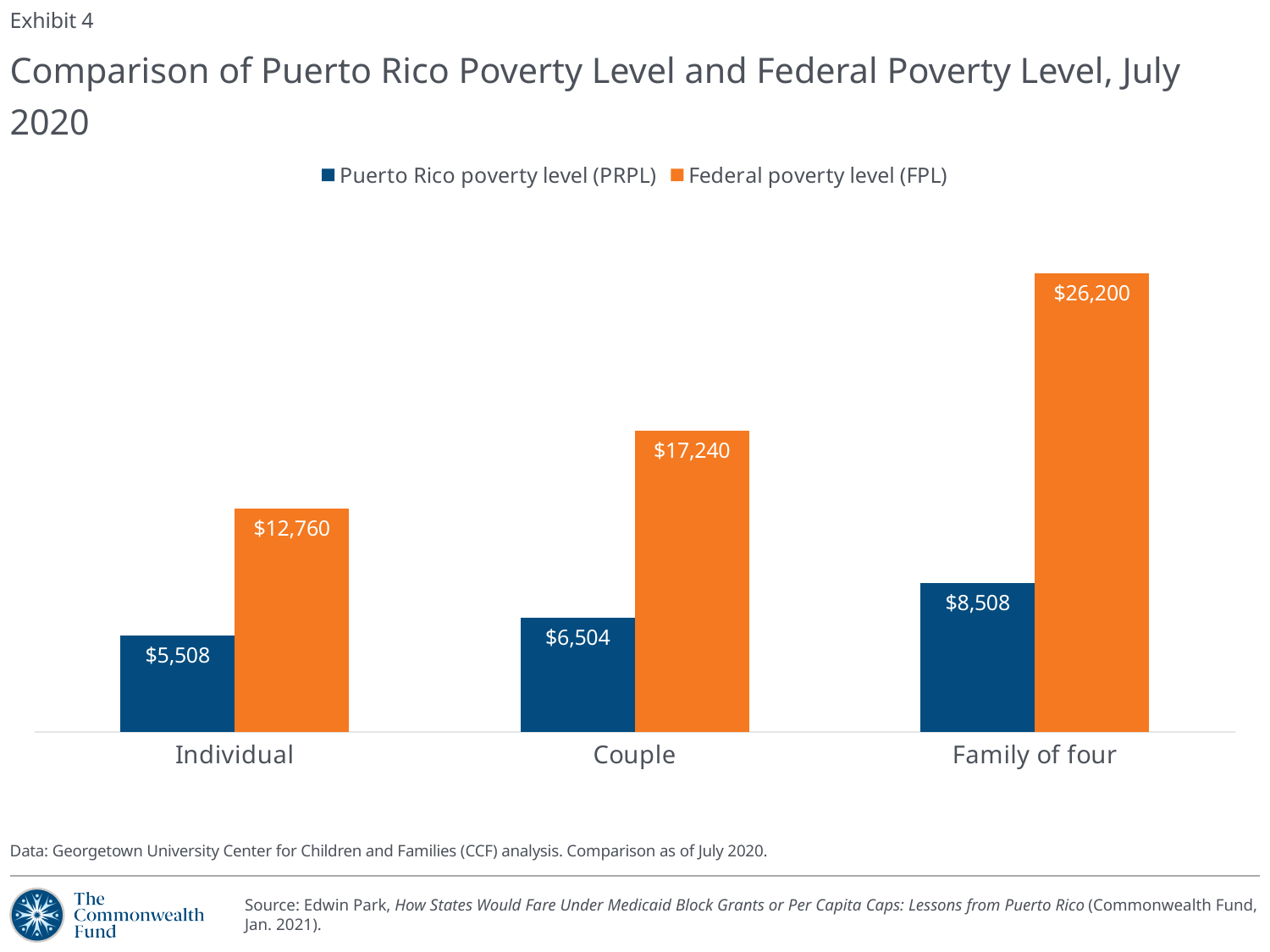
Which category has the highest Federal poverty level (FPL)? Family of four What is the Federal poverty level (FPL) for a Couple? $17,240 What is the difference between the Federal poverty level and the Puerto Rico poverty level for a Family of four? $17,692 What is the Puerto Rico poverty level (PRPL) for an Individual? $5,508 How many series does the legend list? 2 How many categories are shown on the x axis? 3 What is the difference between the Federal poverty level and the Puerto Rico poverty level for an Individual? $7,252 What is the Federal poverty level (FPL) for a Family of four? $26,200 What kind of chart is shown on the slide? Bar chart Which is larger for a Couple: the Puerto Rico poverty level or the Federal poverty level? Federal poverty level Which category has the lowest Puerto Rico poverty level (PRPL)? Individual What is the Puerto Rico poverty level (PRPL) for a Family of four? $8,508